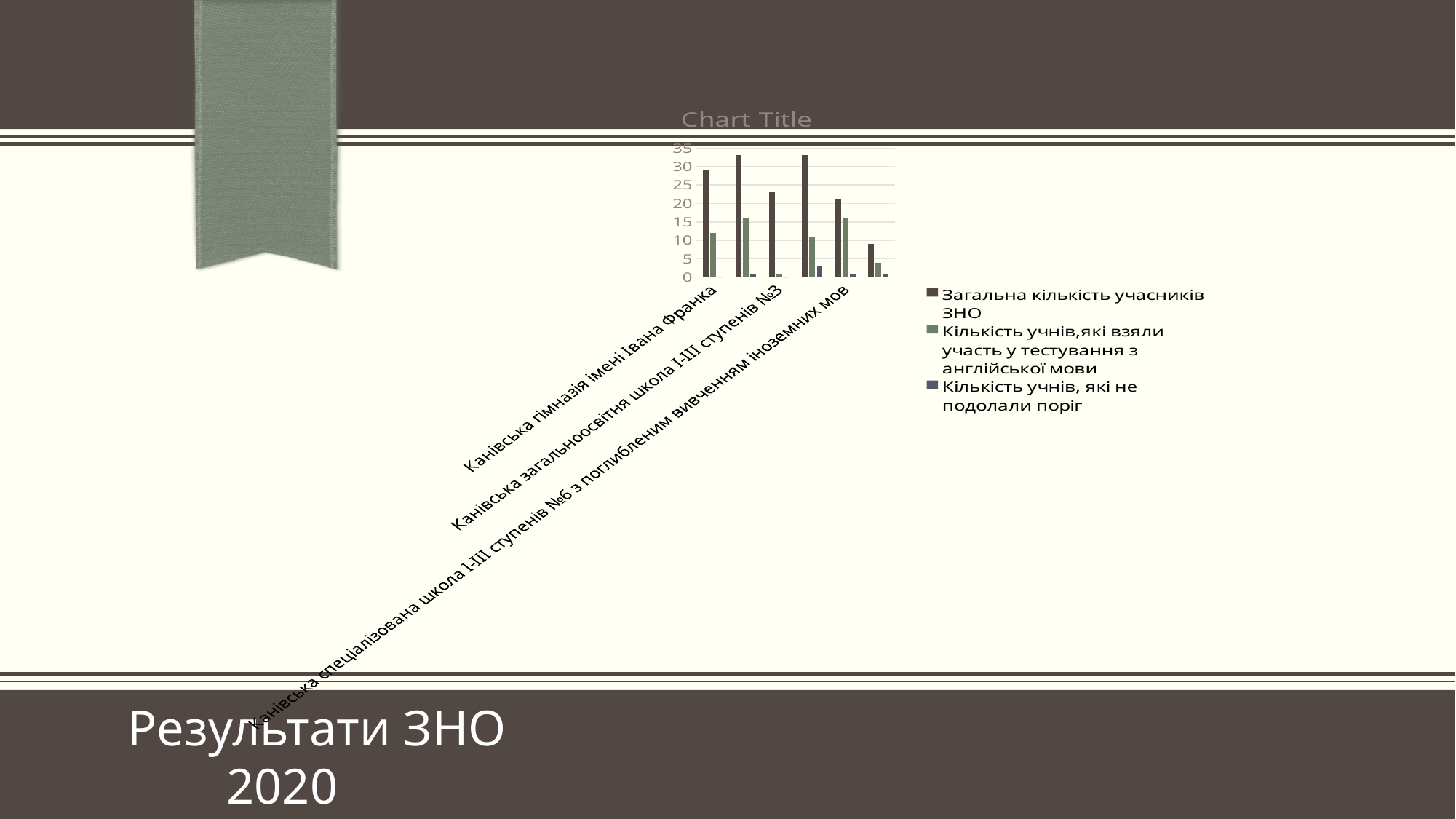
Is the highest value of the series 'Кількість учнів, які не подолали поріг' greater or less than 5? less Is the highest value of the series 'Кількість учнів,які взяли участь у тестування з англійської мови' greater or less than 20? less What kind of chart is shown on the slide? bar chart Is the highest value of the series 'Загальна кількість учасників ЗНО' greater or less than 30? greater What is the title shown above the chart? Chart Title Which series has the tallest bars in the chart: 'Загальна кількість учасників ЗНО' or 'Кількість учнів, які не подолали поріг'? Загальна кількість учасників ЗНО How many series does the chart legend list? 3 What is the maximum value shown on the chart's vertical axis? 35 What is the first series listed in the chart legend? Загальна кількість учасників ЗНО